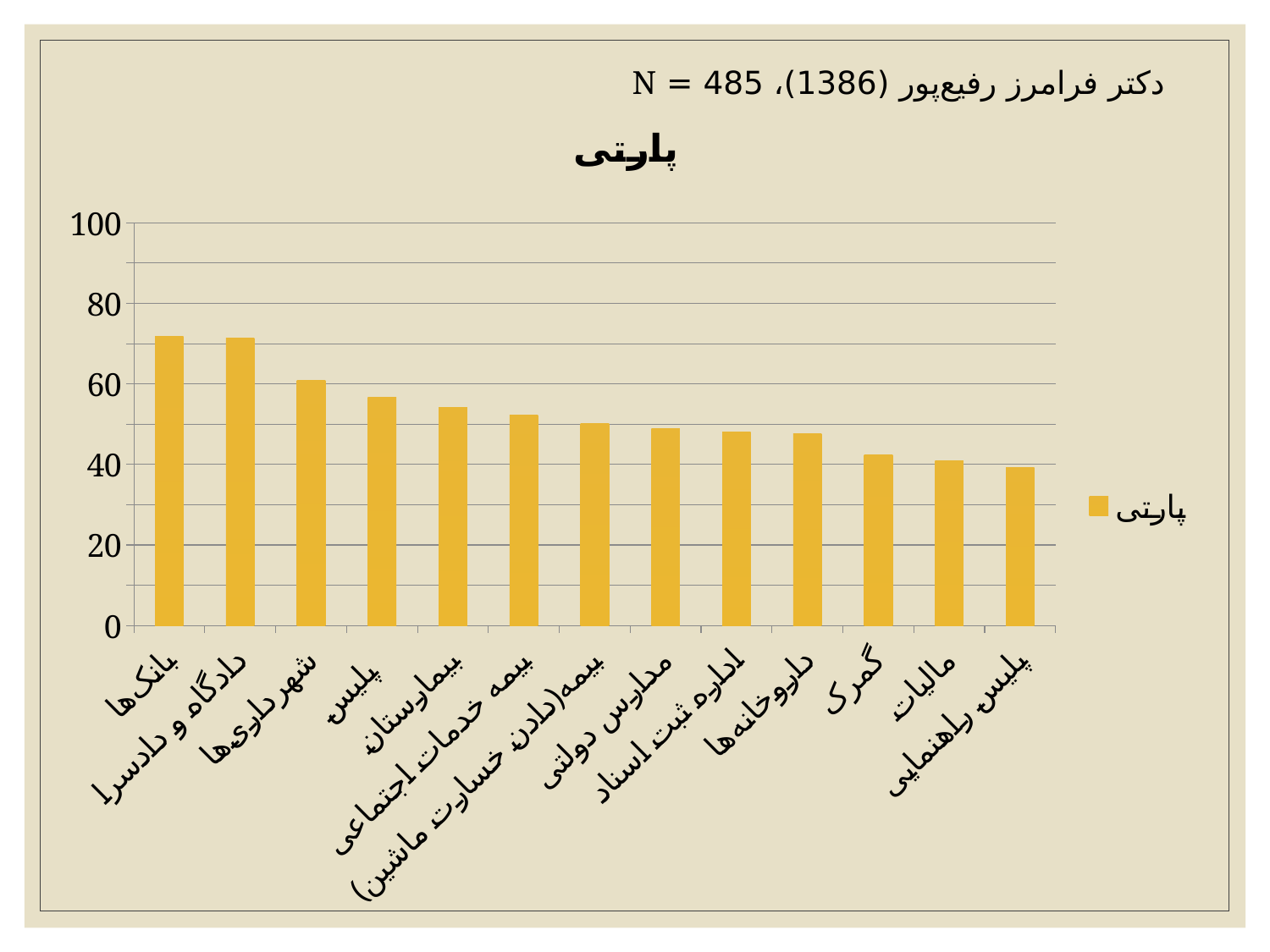
Which has the larger value, شهرداری‌ها or مالیات? شهرداری‌ها Is the value for پلیس راهنمایی greater or less than 60? less Is the value for بیمارستان greater or less than 40? greater How many categories are plotted on the x axis of the chart? 13 What kind of chart is shown on the slide? bar chart How many series does the legend list? 1 Is the value for گمرک greater or less than 60? less What is the title of the chart? پارتی Which has the larger value, بانک‌ها or گمرک? بانک‌ها What is the highest value shown on the y axis of the chart? 100 Do the bar values rise or fall from left to right along the x axis? fall